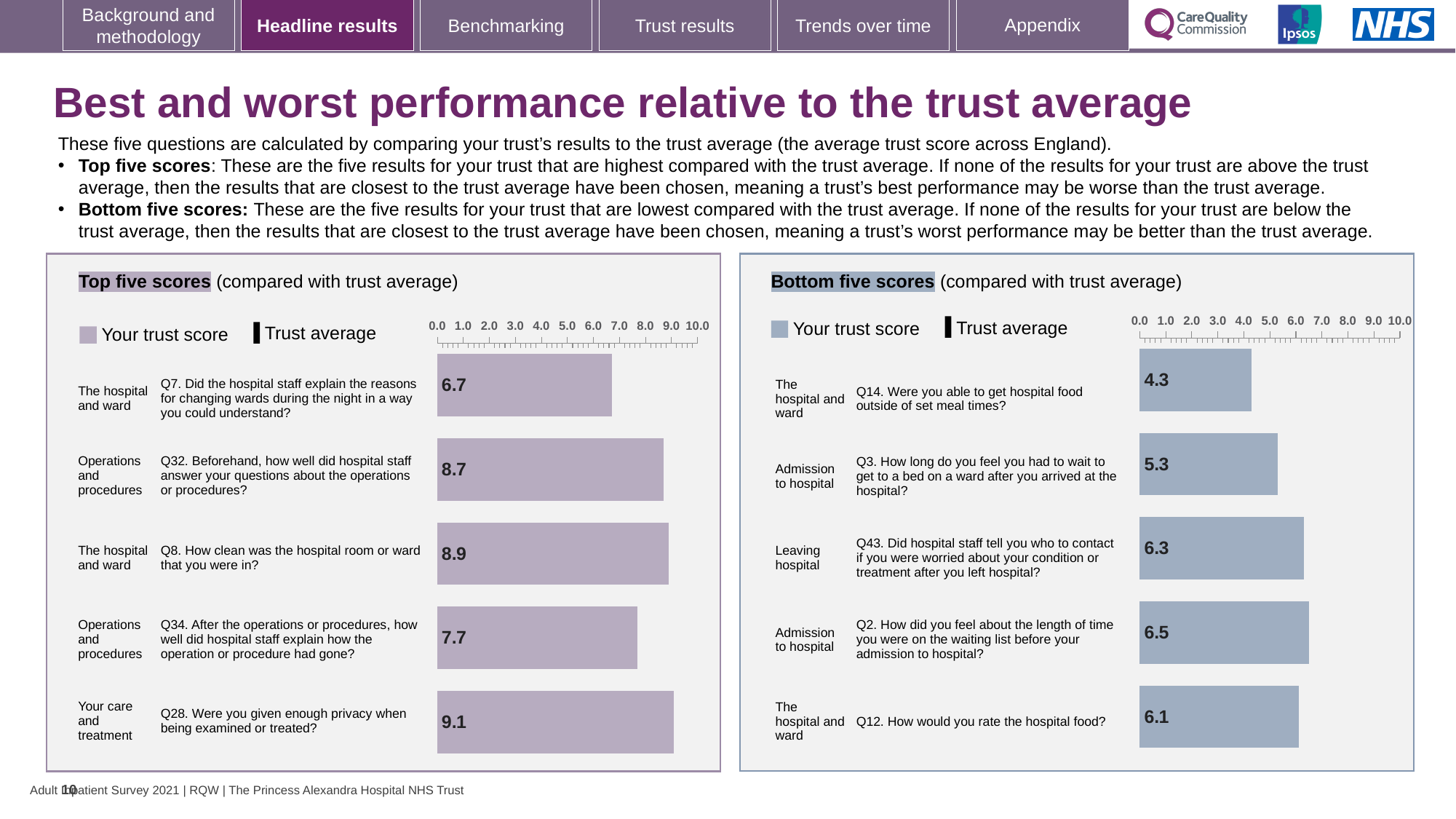
In the Bottom five scores chart, which question has the lowest trust score? Q14. Were you able to get hospital food outside of set meal times? What type of chart is used for the Top five scores? Bar chart In the Top five scores chart, what is the trust score for Q28 (Were you given enough privacy when being examined or treated?)? 9.1 In the Top five scores chart, which question has the highest trust score? Q28. Were you given enough privacy when being examined or treated? In the Bottom five scores chart, what is the difference between the scores for Q2 and Q3? 1.2 How many questions are shown in the Bottom five scores chart? 5 In the Top five scores chart, what is the trust score for Q7 about explaining the reasons for changing wards during the night? 6.7 In the Top five scores chart, what is the difference between the scores for Q8 (8.9) and Q34 (7.7)? 1.2 How many series does the legend of the Top five scores chart list? 2 In the Bottom five scores chart, what is the trust score for Q12 (How would you rate the hospital food?)? 6.1 In the Bottom five scores chart, which has the larger score: Q43 or Q2? Q2 In the Bottom five scores chart, what is the trust score for Q14 (Were you able to get hospital food outside of set meal times?)? 4.3